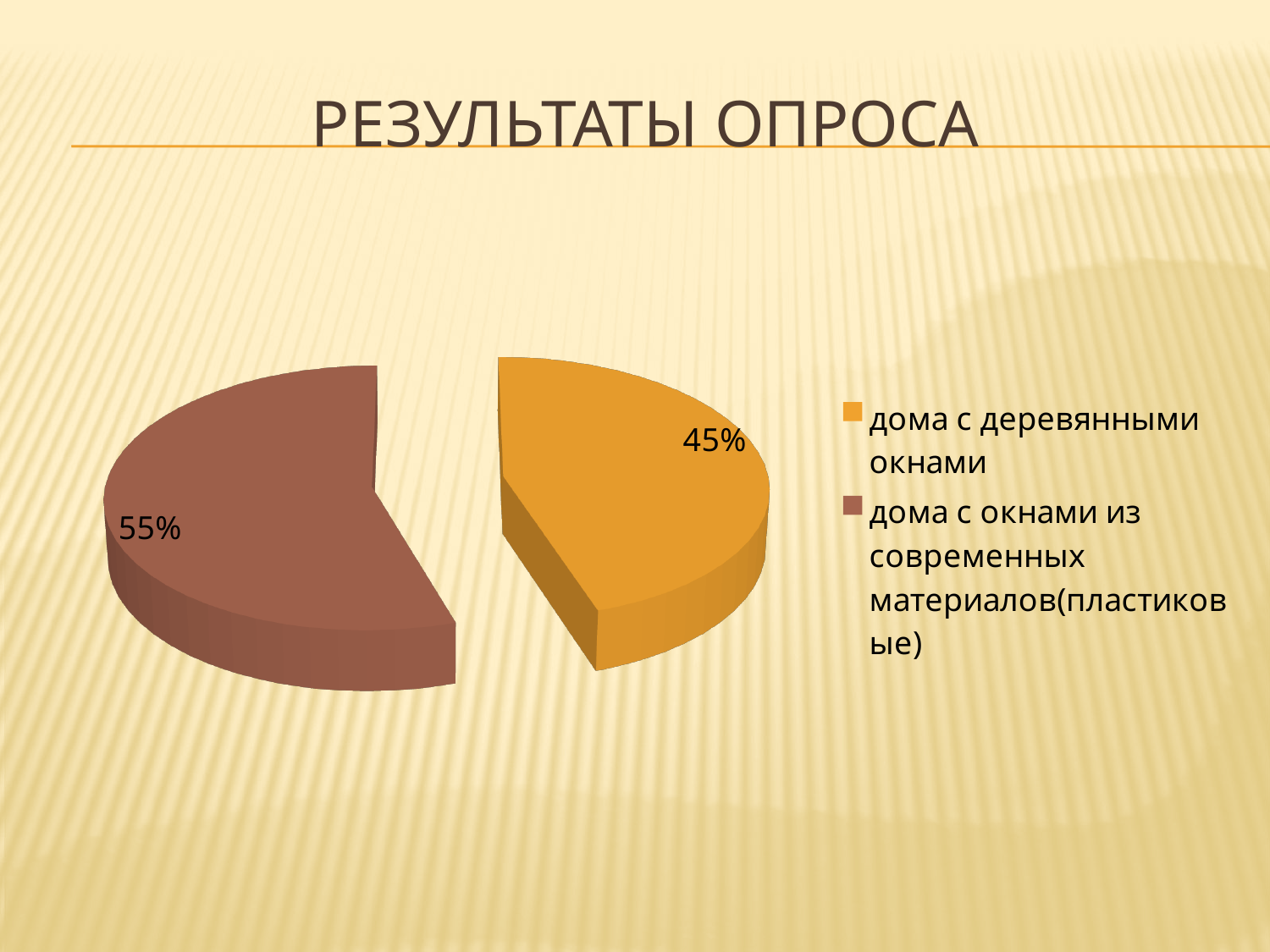
Which category has the smallest slice of the pie? дома с деревянными окнами What is the difference in percentage points between the two slices? 10% What is the total of the two slice percentages shown? 100% What share of the pie is labelled for "дома с окнами из современных материалов(пластиковые)"? 55% What share of the pie is labelled for "дома с деревянными окнами"? 45% Which is larger: the slice for "дома с деревянными окнами" or the slice for "дома с окнами из современных материалов(пластиковые)"? дома с окнами из современных материалов(пластиковые) What kind of chart is shown on the slide? pie chart Which category has the largest slice of the pie? дома с окнами из современных материалов(пластиковые) What is the title of the slide containing the chart? РЕЗУЛЬТАТЫ ОПРОСА How many entries does the legend list? 2 What colour is the slice for "дома с деревянными окнами"? orange How many slices does the pie chart have? 2